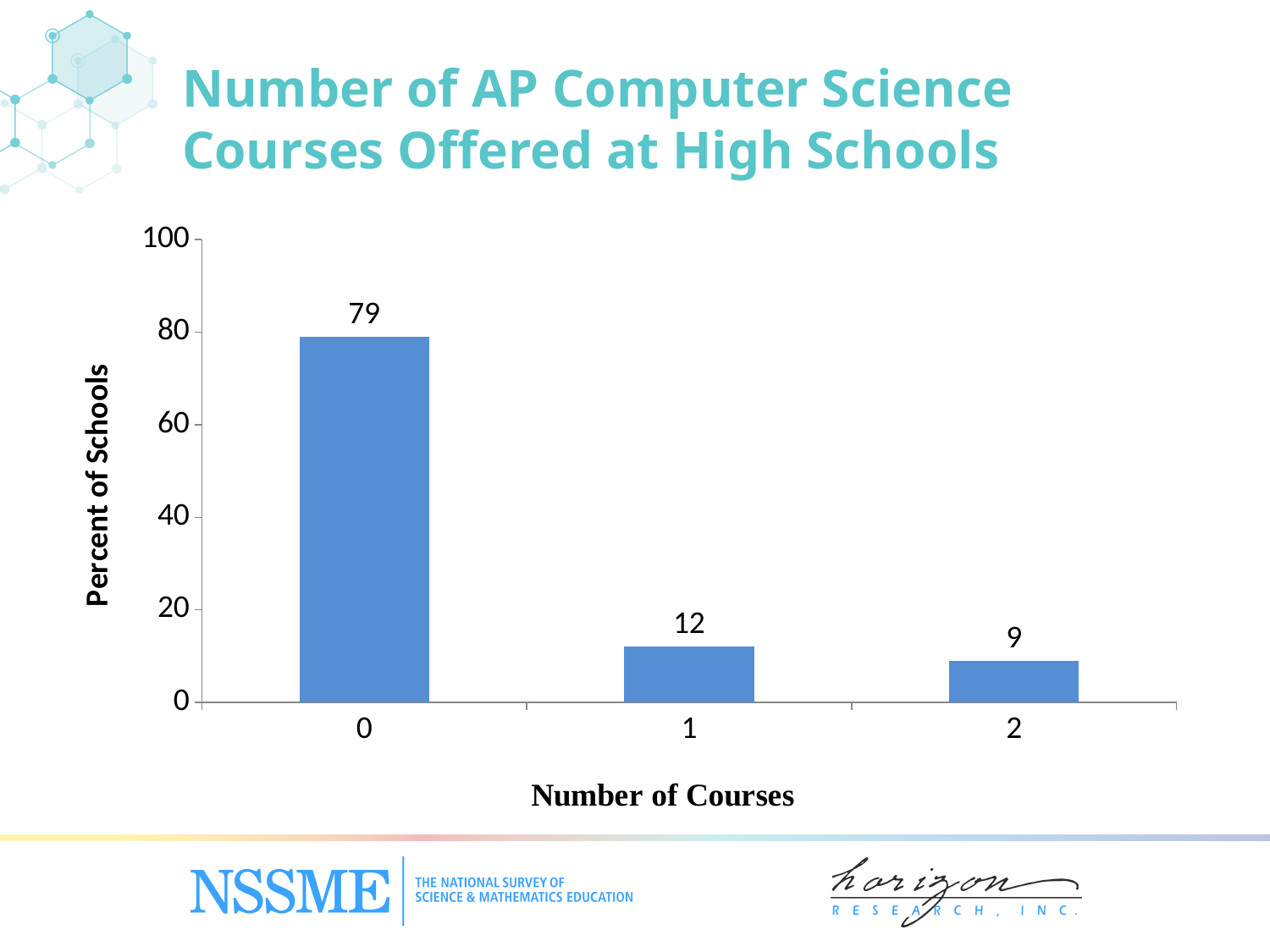
Which number of courses has the lowest percent of schools? 2 What is the difference in percent of schools between 0 courses and 1 course? 67 What percent of schools offer 2 AP Computer Science courses? 9 Is the value for 0 courses greater or less than 60? greater What is the label of the y axis? Percent of Schools How many categories are shown on the x axis? 3 What kind of chart is shown on the slide? bar chart Which has a larger percent of schools: 1 course or 2 courses? 1 course What is the difference in percent of schools between 1 course and 2 courses? 3 What percent of schools offer 1 AP Computer Science course? 12 Which number of courses has the highest percent of schools? 0 What percent of schools offer 0 AP Computer Science courses? 79